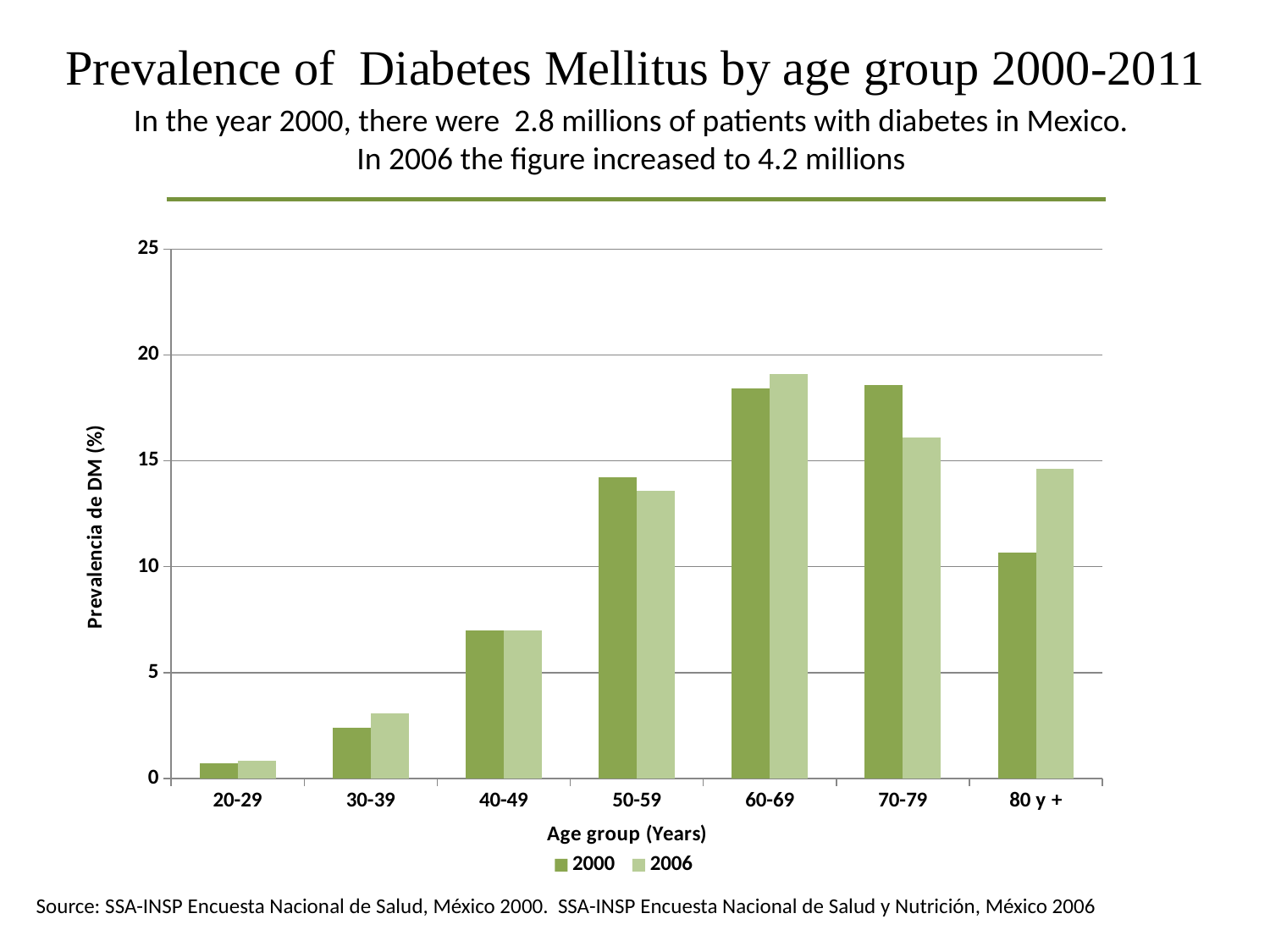
Is the 2000 value for the 80 y + age group greater or less than 10? greater What is the label of the y axis of the chart? Prevalencia de DM (%) Is the 2006 value for the 60-69 age group greater or less than 15? greater How many age groups are shown on the x axis of the chart? 7 For the 70-79 age group, which series has the larger value, 2000 or 2006? 2000 Which age group has the lowest prevalence for the 2000 series? 20-29 Which age group has the lowest prevalence for the 2006 series? 20-29 Which age group has the highest prevalence for the 2006 series? 60-69 For the 80 y + age group, which series has the larger value, 2000 or 2006? 2006 Is the 2006 value for the 30-39 age group greater or less than 5? less What kind of chart is shown on the slide? bar chart How many series does the chart's legend list? 2